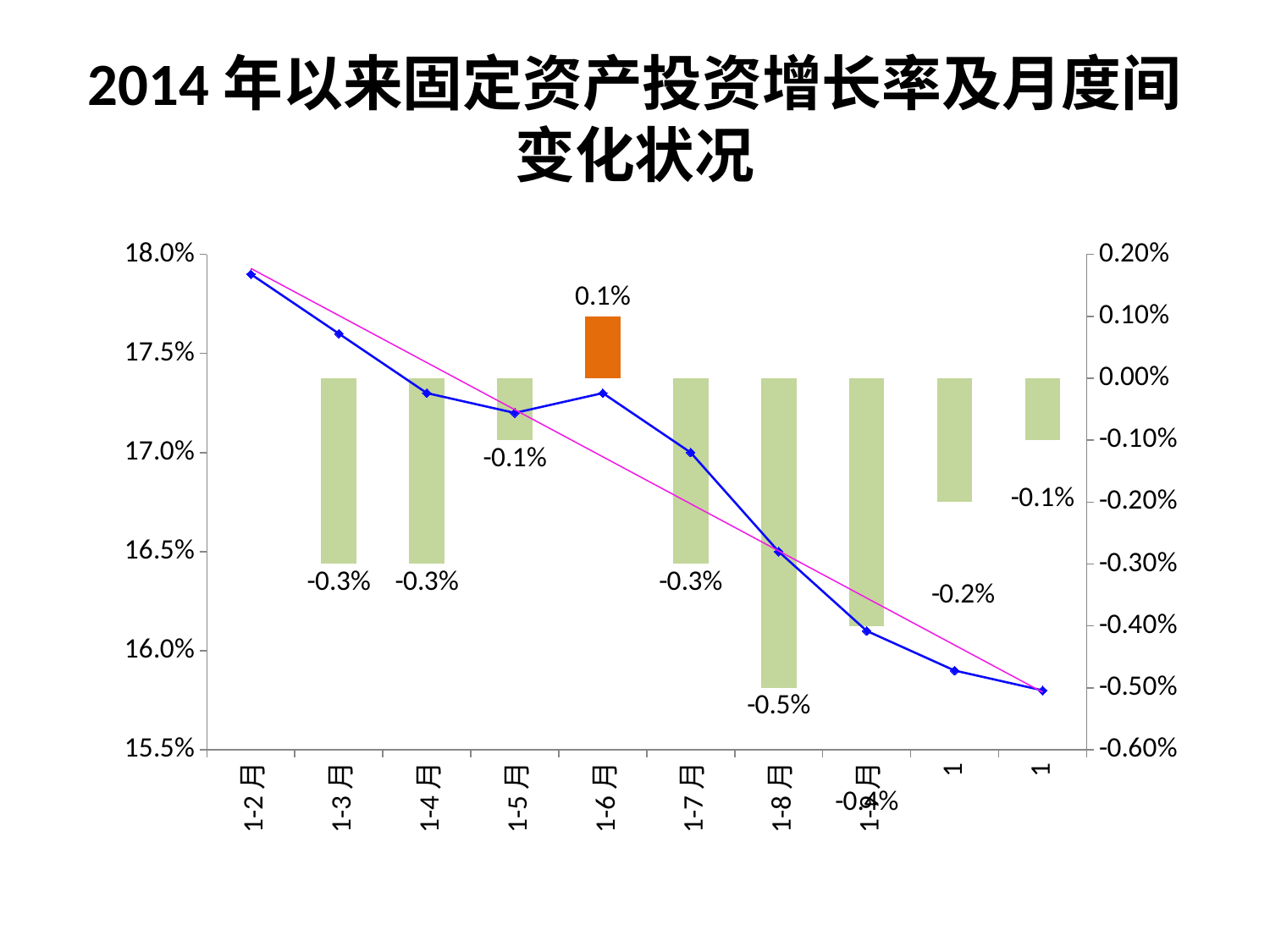
Does the blue line rise or fall from left to right along the x axis? fall What is the monthly change value shown for the 1-5月 bar? -0.1% What is the monthly change value shown for the 1-8月 bar? -0.5% Is the line value for 1-4月 greater or less than 17.5%? less Is the line value for 1-2月 greater or less than 17.5%? greater Which category has the lowest bar value? 1-8月 What colour is the bar for 1-6月? orange What kind of chart is shown on the slide? bar and line chart Which category has the highest bar value? 1-6月 Which bar value is larger, 1-5月 or 1-7月? 1-5月 What is the monthly change value shown for the 1-6月 bar? 0.1% What is the difference between the bar values for 1-6月 and 1-8月? 0.6%